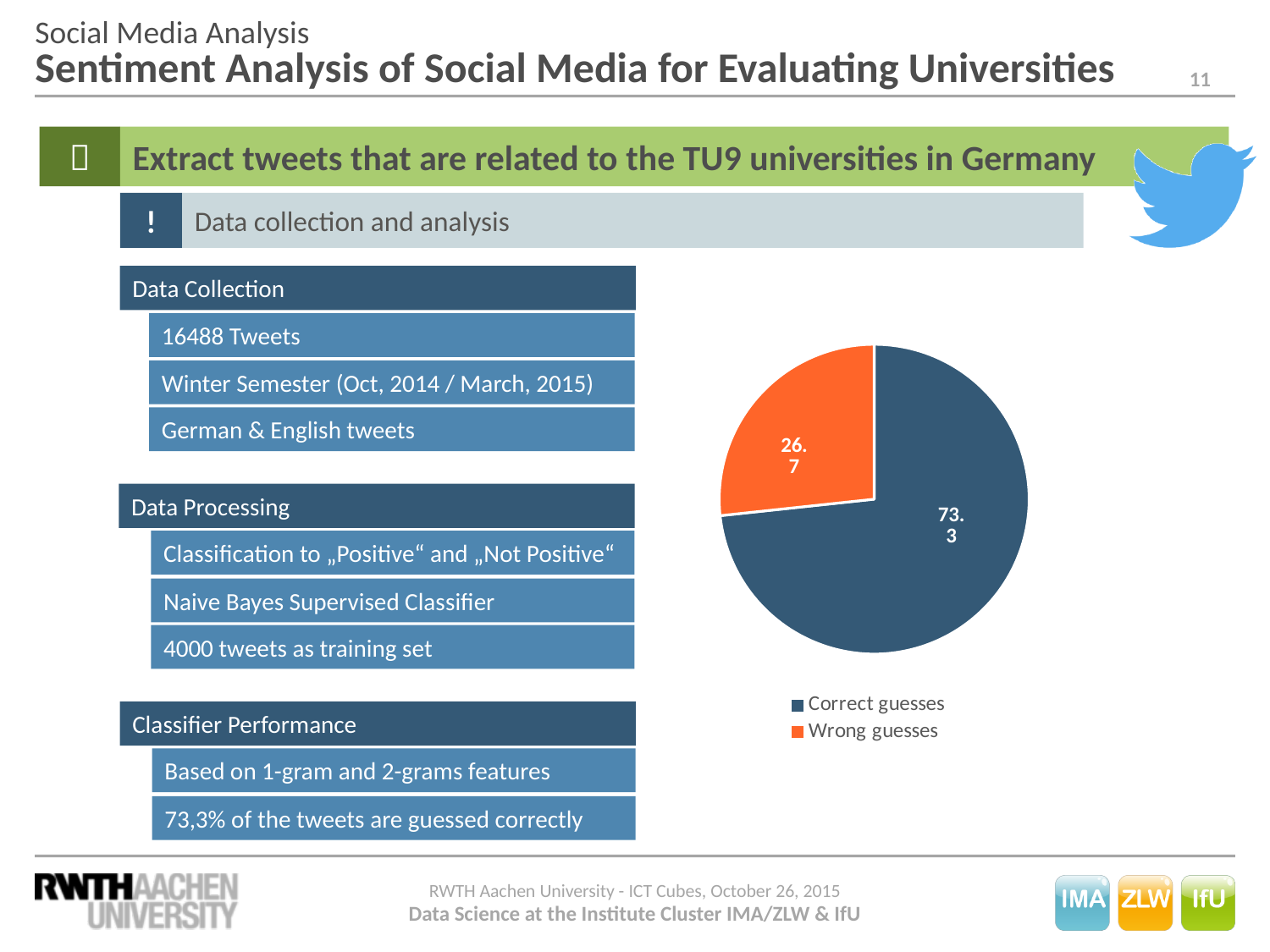
What colour is the Wrong guesses slice in the pie chart? orange What colour is the Correct guesses slice in the pie chart? dark blue How many entries does the legend of the pie chart list? 2 What is the total of the two values shown in the pie chart? 100 What is the difference between the Correct guesses and Wrong guesses values in the pie chart? 46.6 What is the value shown for Wrong guesses in the pie chart? 26.7 What is the value shown for Correct guesses in the pie chart? 73.3 How many slices does the pie chart have? 2 Which slice of the pie chart is the largest? Correct guesses Which is larger in the pie chart, Correct guesses or Wrong guesses? Correct guesses Which slice of the pie chart is the smallest? Wrong guesses What kind of chart is shown on the slide? pie chart